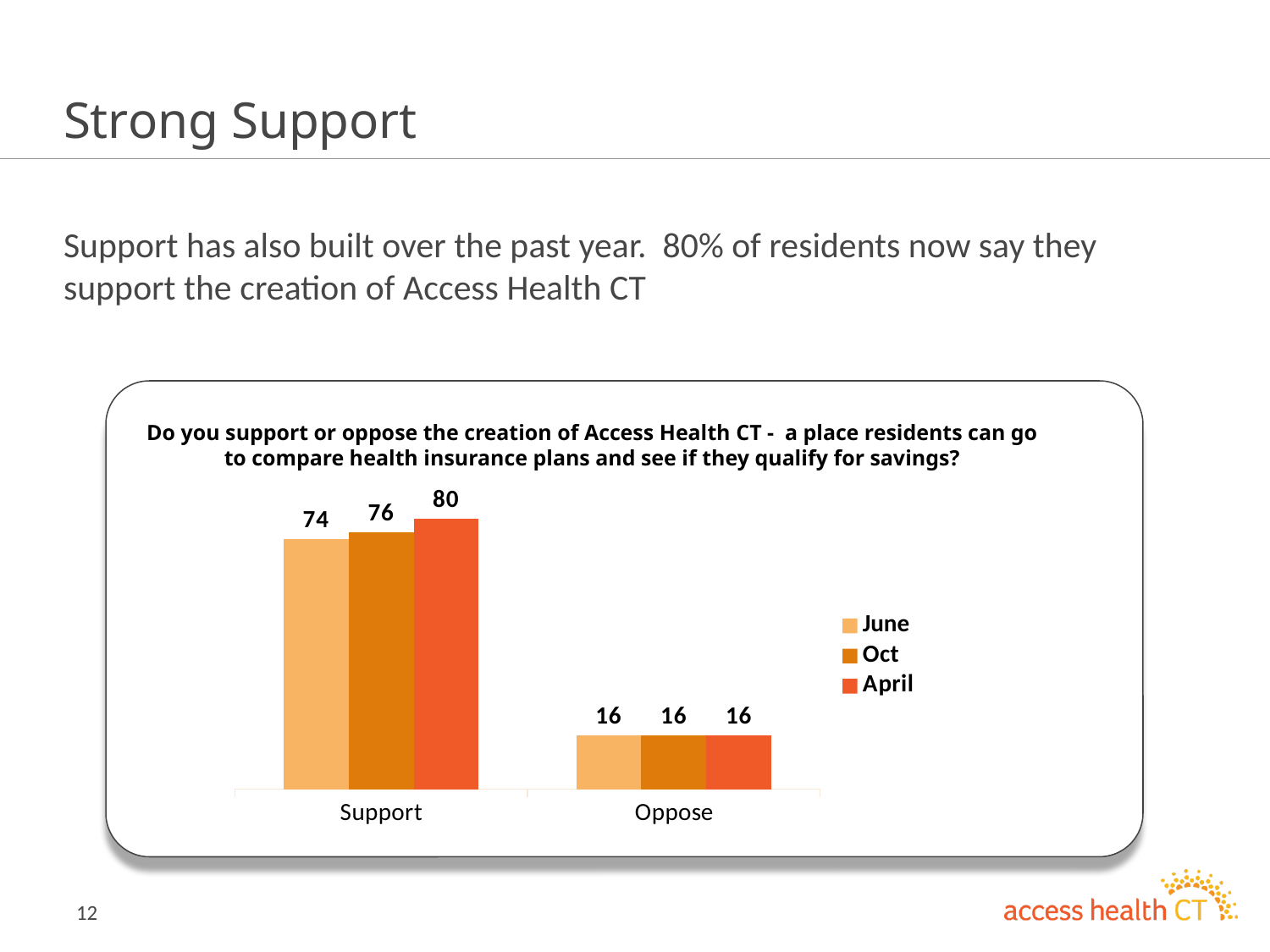
What is the value for Support in April? 80 Which series has the highest value for Support? April How many series does the legend list? 3 What kind of chart is shown? bar chart Which is larger, the Oct value for Support or the Oct value for Oppose? Support What is the difference between the Support and Oppose values for Oct? 60 How many categories are shown on the x axis? 2 What is the difference between the April and June values for Support? 6 Which series has the lowest value for Support? June What is the value for Support in June? 74 What is the value for Oppose in Oct? 16 Do the Support values rise or fall from June to April? rise